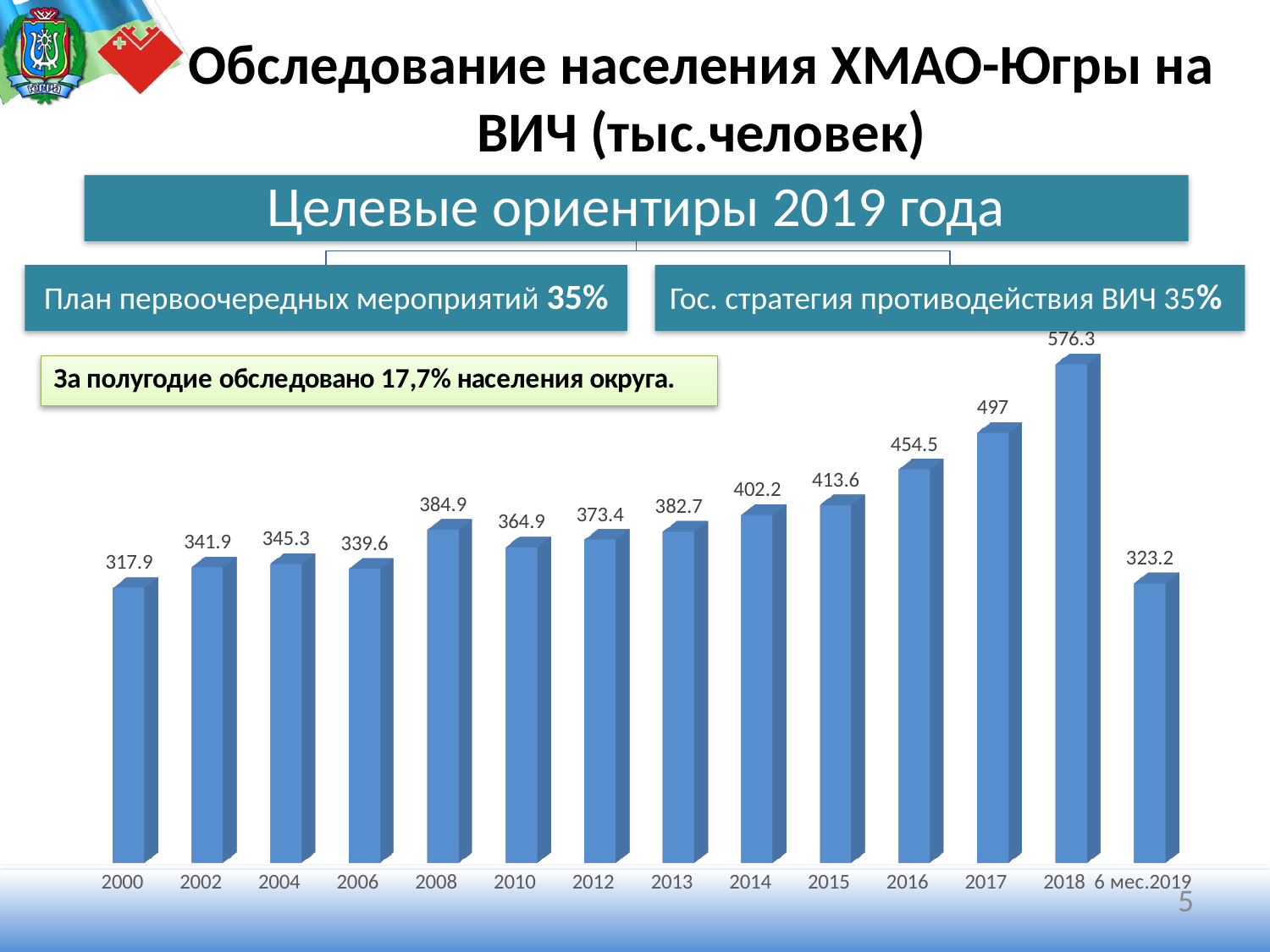
Which category has the highest value? 2018 How many categories are shown on the x axis? 14 Do the values generally rise or fall from 2010 to 2018? rise What is the value for 2000? 317.9 Which category has the lowest value? 2000 Which is larger, the value for 2008 or the value for 2010? 2008 What is the value for 6 мес.2019? 323.2 What is the value for 2018? 576.3 What is the value for 2016? 454.5 What kind of chart is shown on the slide? bar chart What is the difference between the values for 2018 and 2017? 79.3 What is the difference between the values for 2014 and 2013? 19.5